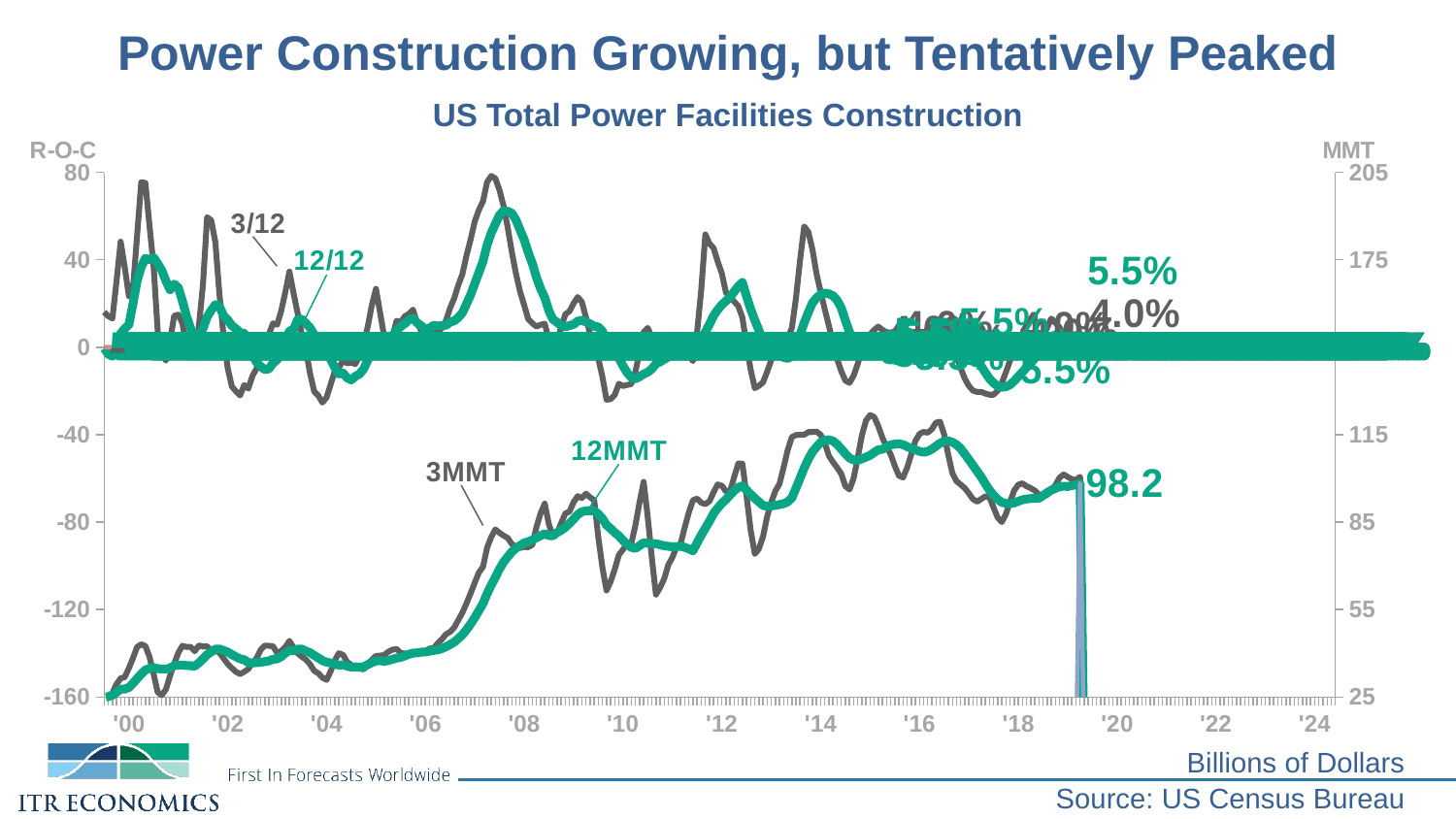
Is the 12MMT value in '04 greater or less than 55 on the MMT axis? less What is the first year shown on the x axis? '00 Which series is labeled with the value 98.2? 12MMT How many series are labeled on the chart? 4 What is the latest value labeled on the 12MMT line? 98.2 What is the last year shown on the x axis? '24 In what units are the values expressed, according to the note at the bottom right? Billions of Dollars Is the 12MMT value in '16 greater or less than 85 on the MMT axis? greater What kind of chart is shown on the slide? line chart Does the 12MMT line generally rise or fall from '00 to '18? rise What is the title of the chart? US Total Power Facilities Construction Is the 12MMT value in '18 greater or less than 115 on the MMT axis? less